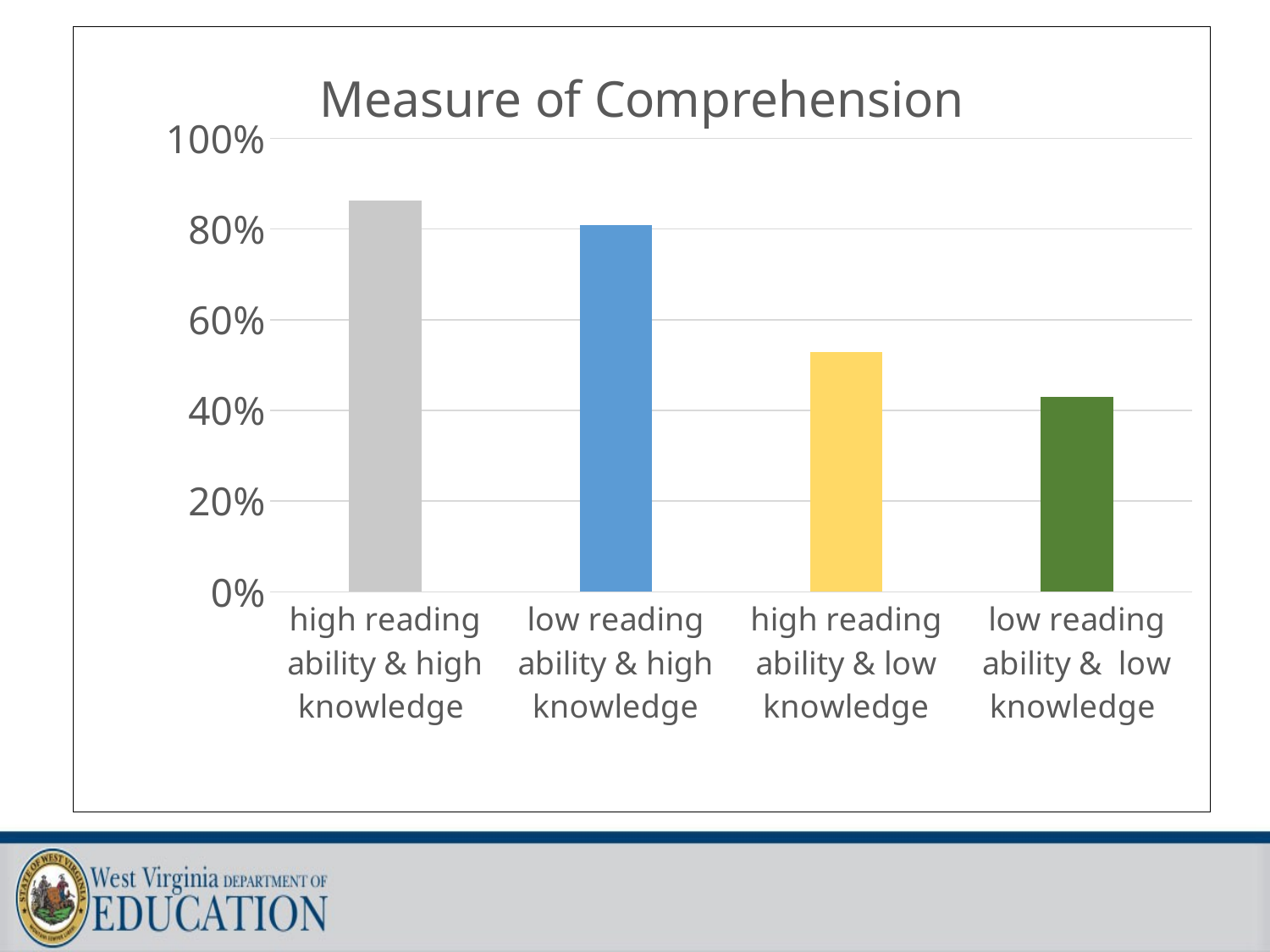
Is the value for low reading ability & low knowledge greater or less than 40%? greater Which category has the highest value in the chart? high reading ability & high knowledge How many categories are shown on the x axis of the chart? 4 Is the value for high reading ability & low knowledge greater or less than 60%? less What kind of chart is shown on the slide? bar chart Do the values rise or fall from left to right along the x axis? fall What colour is the bar for low reading ability & high knowledge? blue Which is larger: the value for low reading ability & high knowledge or the value for high reading ability & low knowledge? low reading ability & high knowledge What is the title of the chart? Measure of Comprehension Which category has the lowest value in the chart? low reading ability & low knowledge Is the value for high reading ability & high knowledge greater or less than 80%? greater